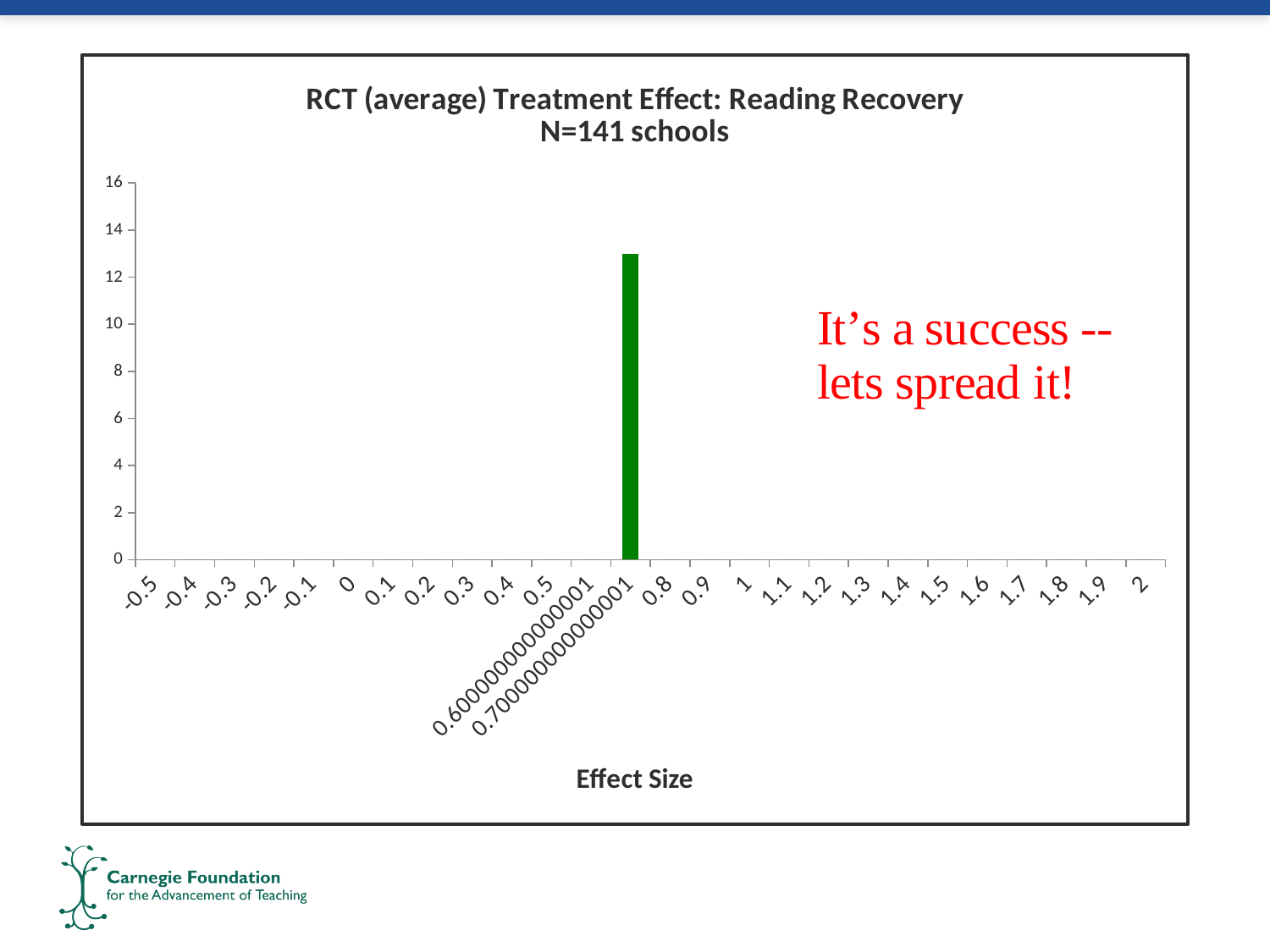
What is the highest value shown on the y axis? 16 What kind of chart is shown on the slide? bar chart Is the height of the bar at effect size 0.700000000000001 greater or less than 10? greater At which effect size value is the single bar plotted? 0.700000000000001 Is the height of the bar at effect size 0.700000000000001 greater or less than 12? greater Is the height of the bar at effect size 0.700000000000001 greater or less than 14? less How many schools does the chart title say were in the RCT? 141 How many bars are plotted in the chart? 1 What is the lowest effect size label shown on the x axis? -0.5 What is the title of the chart? RCT (average) Treatment Effect: Reading Recovery N=141 schools What is the label on the x axis of the chart? Effect Size What is the highest effect size label shown on the x axis? 2